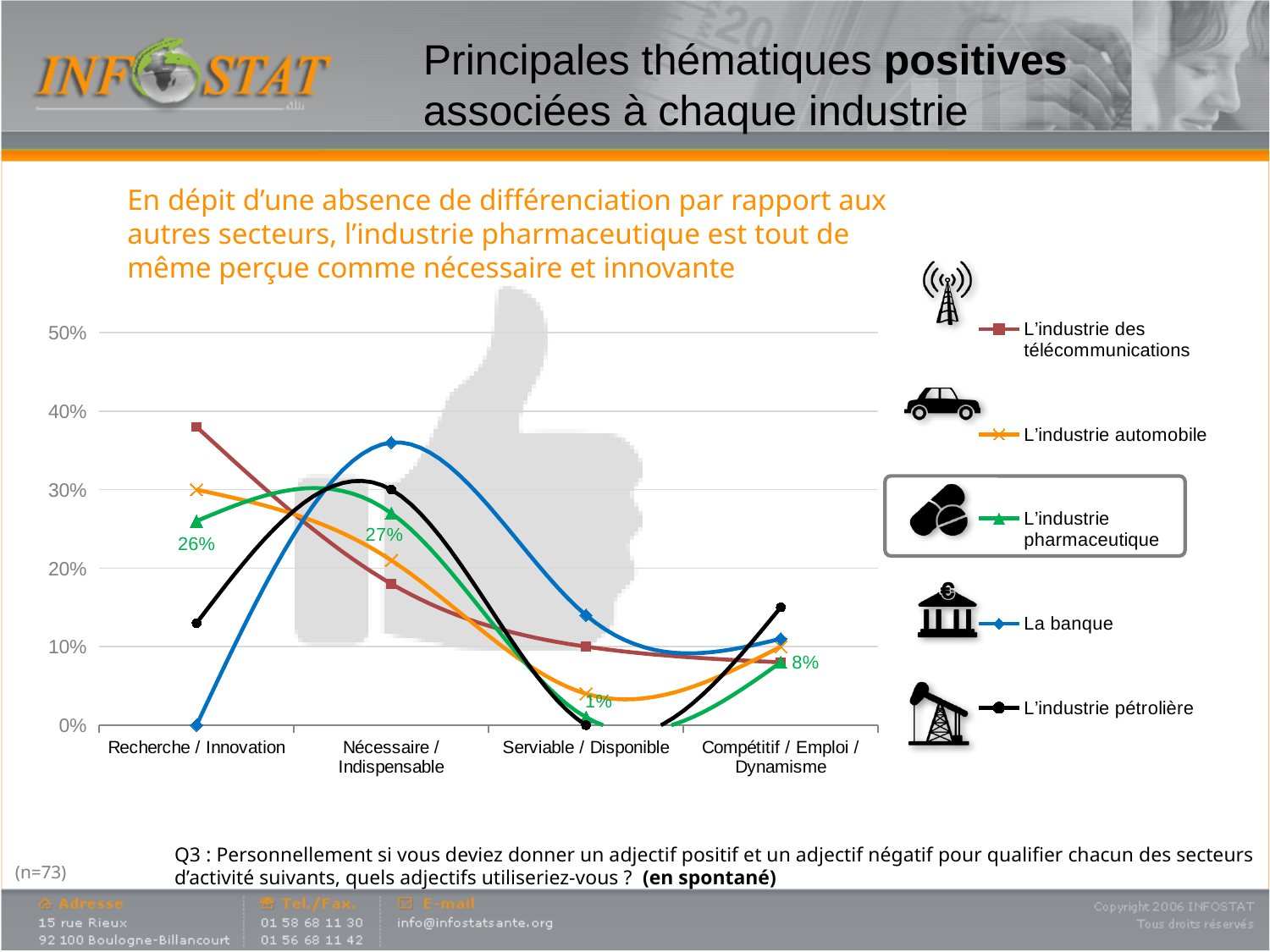
How many series does the legend list? 5 How many categories are shown on the x axis? 4 What is the value for L'industrie pharmaceutique at Recherche / Innovation? 26% Is the value for La banque at Nécessaire / Indispensable greater or less than 30%? greater Is the value for L'industrie des télécommunications at Recherche / Innovation greater or less than 30%? greater What is the value for L'industrie pharmaceutique at Compétitif / Emploi / Dynamisme? 8% What kind of chart is shown on the slide? Line chart What is the value for L'industrie pharmaceutique at Serviable / Disponible? 1% For L'industrie pharmaceutique, which category has the lowest value? Serviable / Disponible Which series is highlighted with a box around its legend entry? L'industrie pharmaceutique At Recherche / Innovation, which is larger: L'industrie des télécommunications or La banque? L'industrie des télécommunications What is the value for L'industrie pharmaceutique at Nécessaire / Indispensable? 27%